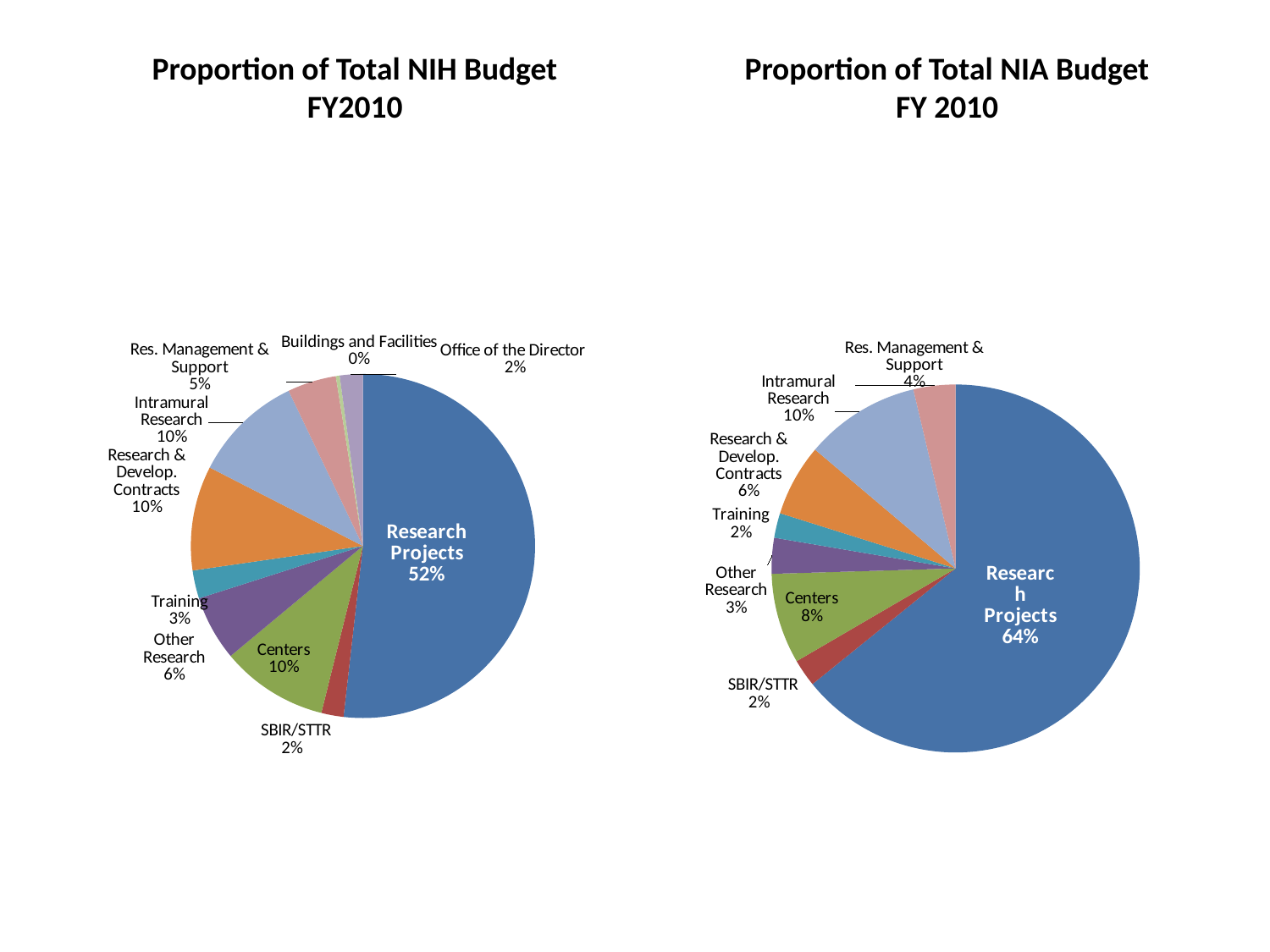
In the 'Proportion of Total NIH Budget FY2010' chart, which category has the largest slice? Research Projects In the 'Proportion of Total NIA Budget FY 2010' chart, which category has the largest slice? Research Projects In the 'Proportion of Total NIH Budget FY2010' chart, which is larger: Other Research or Training? Other Research In the 'Proportion of Total NIH Budget FY2010' chart, which category has the smallest share? Buildings and Facilities In the 'Proportion of Total NIA Budget FY 2010' chart, what percentage is shown for Intramural Research? 10% How many categories are shown in the 'Proportion of Total NIH Budget FY2010' chart? 10 In the 'Proportion of Total NIH Budget FY2010' chart, what share of the budget goes to Research Projects? 52% How many categories are shown in the 'Proportion of Total NIA Budget FY 2010' chart? 8 In the 'Proportion of Total NIH Budget FY2010' chart, what percentage is shown for Centers? 10% What type of chart is used for the 'Proportion of Total NIA Budget FY 2010'? Pie chart In the 'Proportion of Total NIA Budget FY 2010' chart, what share of the budget goes to Research Projects? 64% What is the difference between the Research Projects share in the NIA chart and the Research Projects share in the NIH chart? 12 percentage points